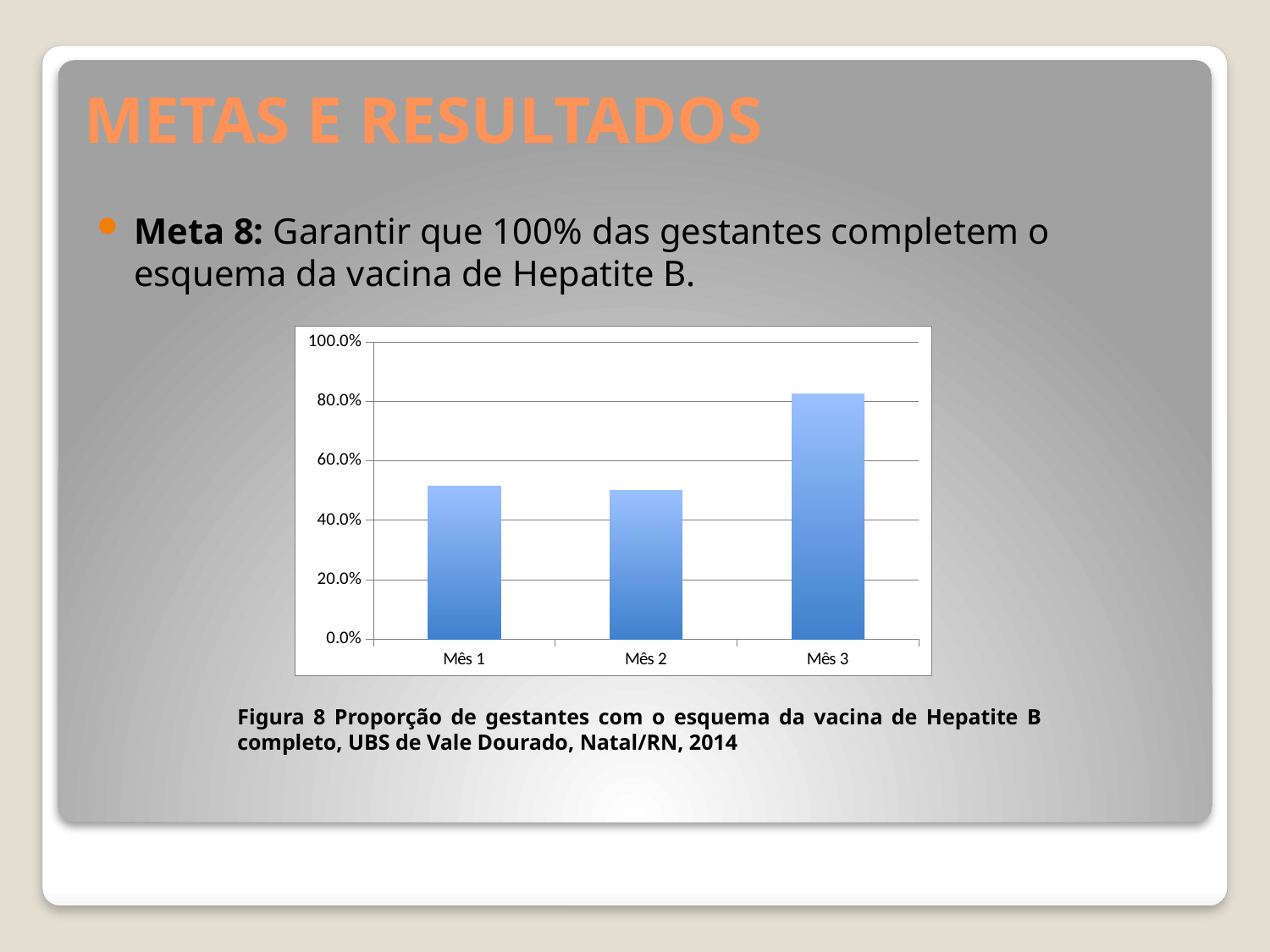
Is the value for Mês 1 greater or less than 40.0%? greater Does the value rise or fall from Mês 2 to Mês 3? rise Is the value for Mês 2 greater or less than 40.0%? greater Which month has the highest bar in the chart? Mês 3 How many categories (months) are shown on the x axis of the chart? 3 Is the value for Mês 1 greater or less than 60.0%? less Which is larger, the value for Mês 2 or the value for Mês 3? Mês 3 What figure number is given in the caption below the chart? Figura 8 What kind of chart is shown on the slide? bar chart What is the highest value shown on the y axis of the chart? 100.0%